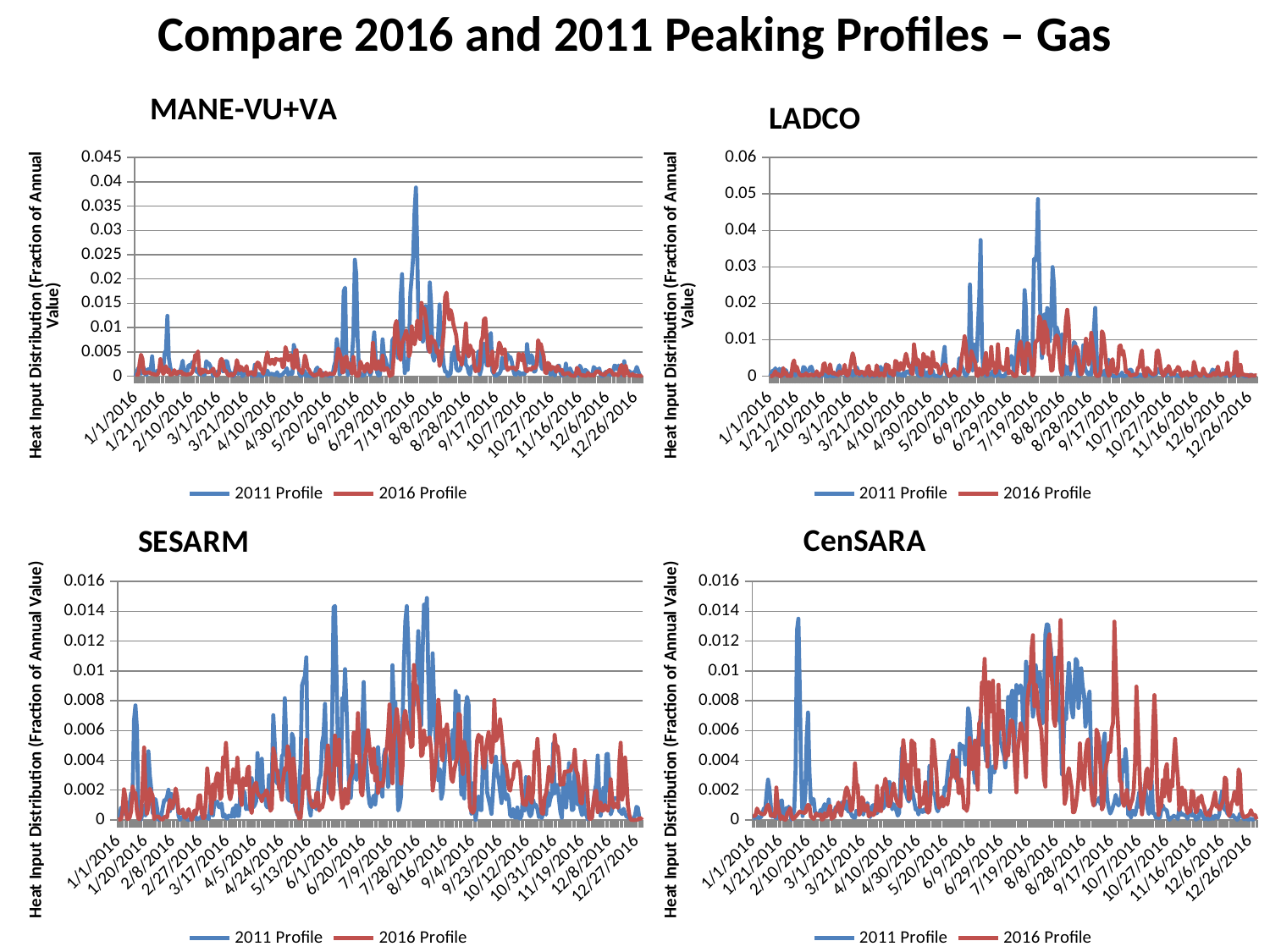
On the MANE-VU+VA chart, is the highest value of the 2011 Profile greater or less than 0.035? greater On the LADCO chart, how many series does the legend list? 2 On the CenSARA chart, is the highest value of the 2011 Profile greater or less than 0.012? greater On the MANE-VU+VA chart, what kind of chart is shown? Line chart On the LADCO chart, is the highest value of the 2011 Profile greater or less than 0.04? greater On the LADCO chart, which series reaches the higher peak value, 2011 Profile or 2016 Profile? 2011 Profile On the MANE-VU+VA chart, which series reaches the higher peak value, 2011 Profile or 2016 Profile? 2011 Profile On the SESARM chart, what are the two legend entries? 2011 Profile and 2016 Profile On the SESARM chart, what is the maximum value shown on the y axis? 0.016